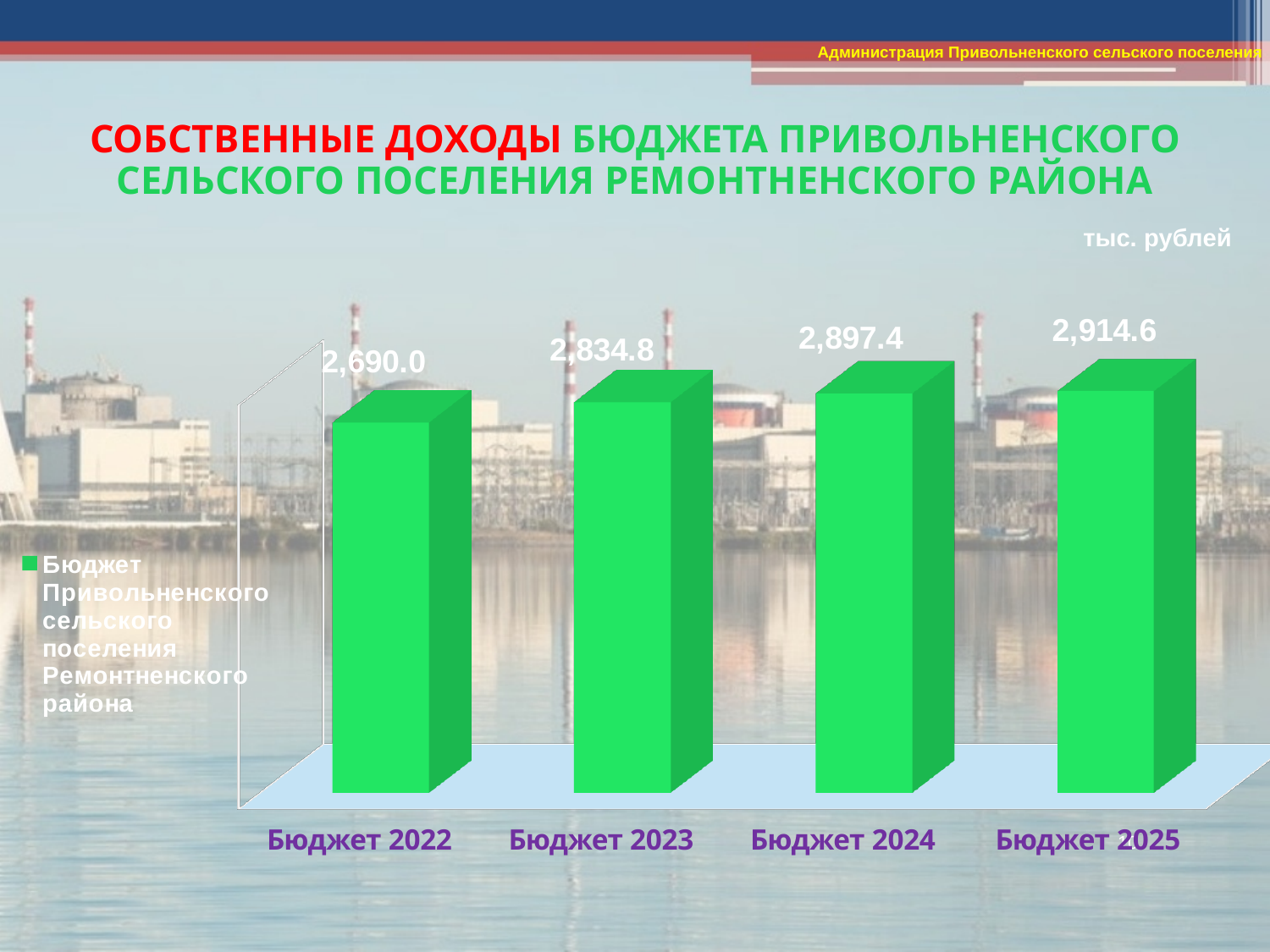
Which is larger, the value for Бюджет 2022 or the value for Бюджет 2024? Бюджет 2024 How many categories are shown on the chart? 4 What is the value for Бюджет 2023? 2,834.8 Which category has the highest value? Бюджет 2025 Do the values rise or fall from Бюджет 2022 to Бюджет 2025? Rise What is the value for Бюджет 2024? 2,897.4 What is the value for Бюджет 2022? 2,690.0 What is the value for Бюджет 2025? 2,914.6 What is the difference between the values for Бюджет 2023 and Бюджет 2022? 144.8 Which category has the lowest value? Бюджет 2022 What kind of chart is shown on the slide? Bar chart What is the difference between the values for Бюджет 2025 and Бюджет 2024? 17.2